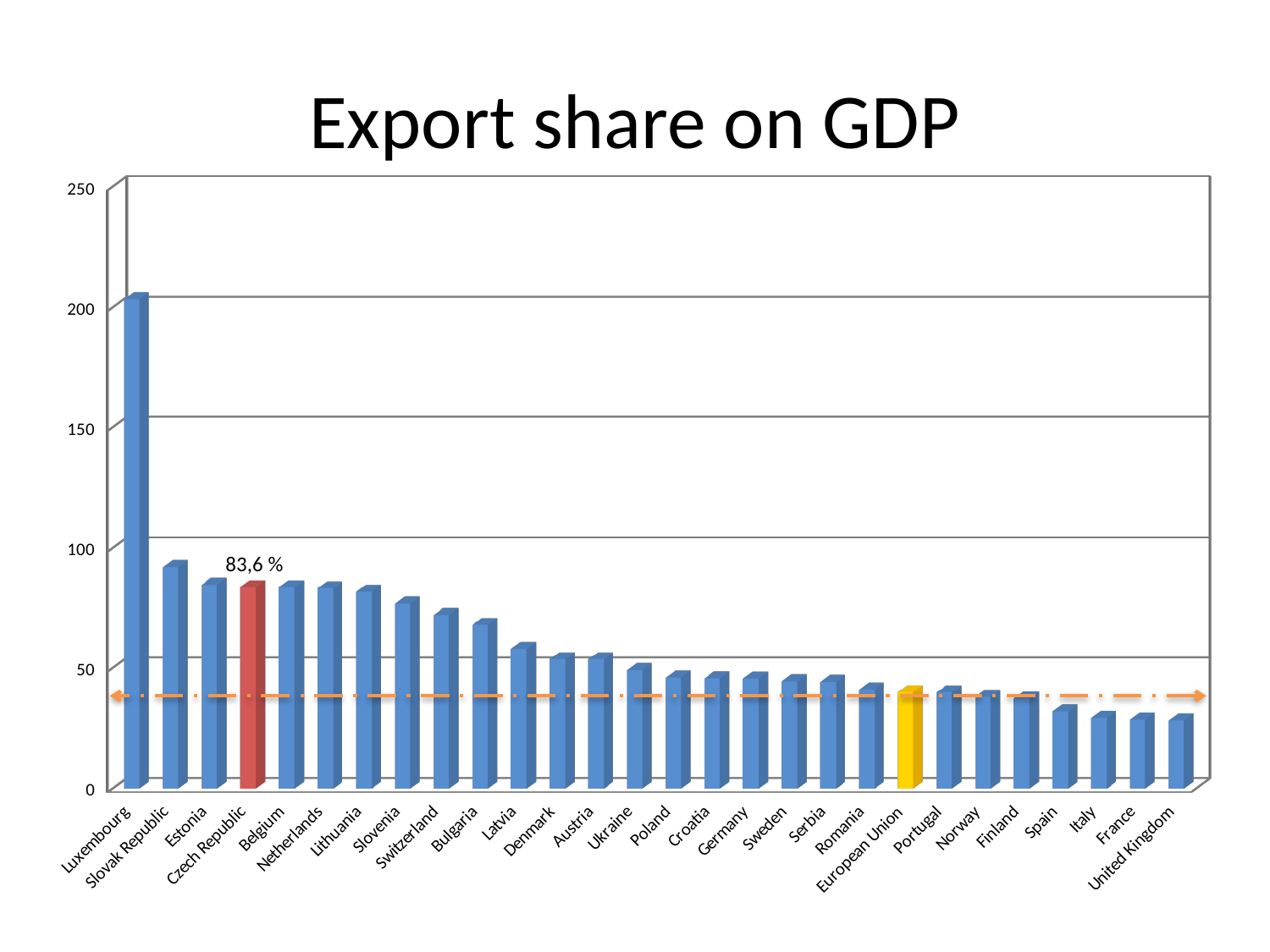
What is the title of the chart? Export share on GDP Do the values generally rise or fall moving from left to right along the x axis? Fall Which country has the highest export share on GDP in the chart? Luxembourg Is the value for Luxembourg greater or less than 150? greater Is the value for Spain greater or less than 50? less Is the value for Belgium greater or less than 100? less What value is labelled on the bar for Czech Republic? 83,6 % How many countries or regions are shown on the x axis? 28 What type of chart is shown on the slide? Bar chart Which has a larger export share on GDP, Bulgaria or Latvia? Bulgaria Which country's bar is coloured red? Czech Republic